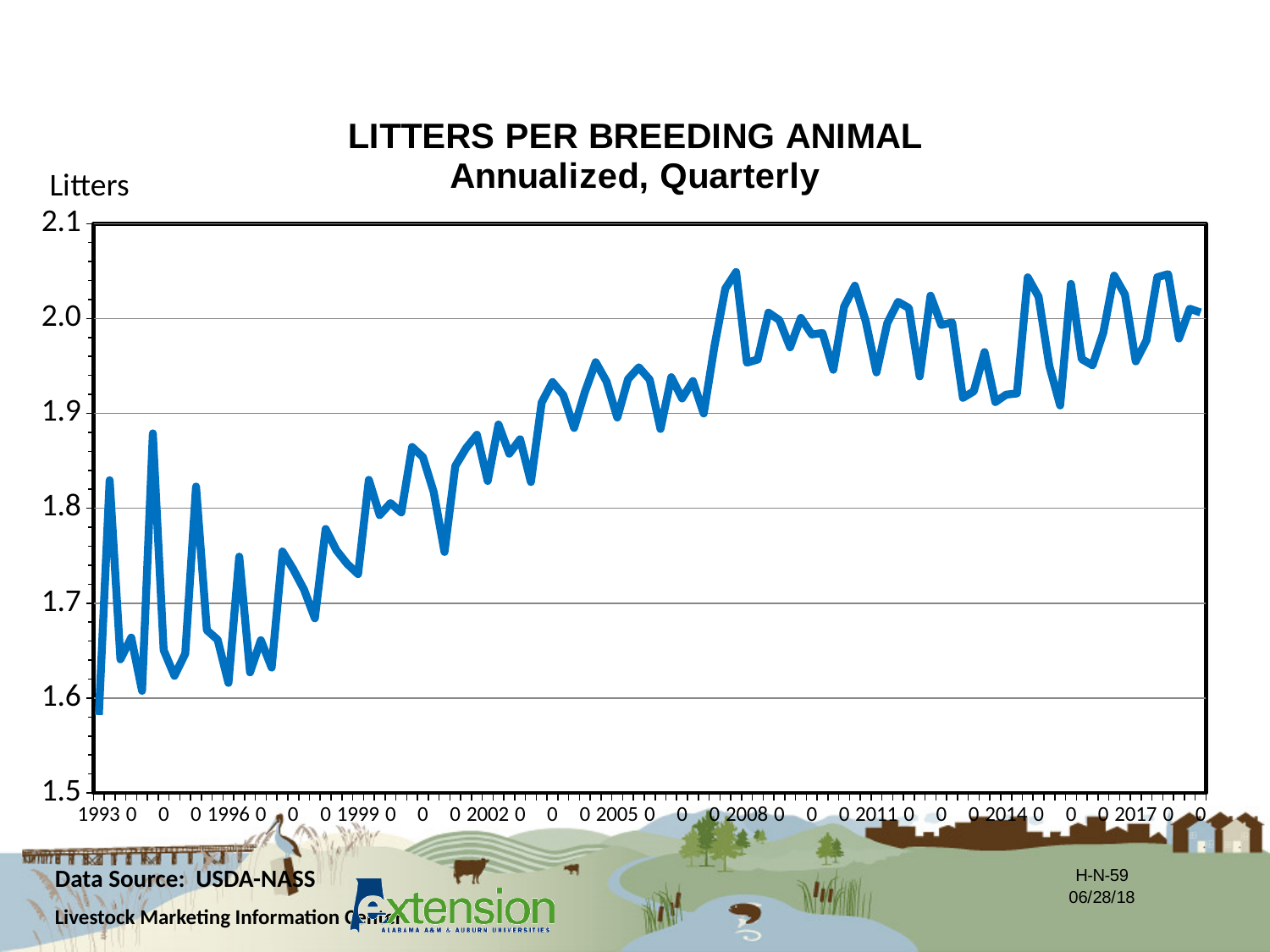
What is the lowest value shown on the vertical axis? 1.5 Is the value at the start of 1993 greater or less than 1.7? less Are the values during 1996 greater or less than 1.8? less What is the title of the chart? LITTERS PER BREEDING ANIMAL Annualized, Quarterly What kind of chart is shown on the slide? line chart Is the value at the start of 2002 greater or less than 1.8? greater What is the label on the vertical axis of the chart? Litters How many data series are plotted on the chart? 1 Which is larger, the value at the start of 1993 or the value at the end of 2017? the value at the end of 2017 Overall, do the values rise or fall from 1993 to 2017? rise